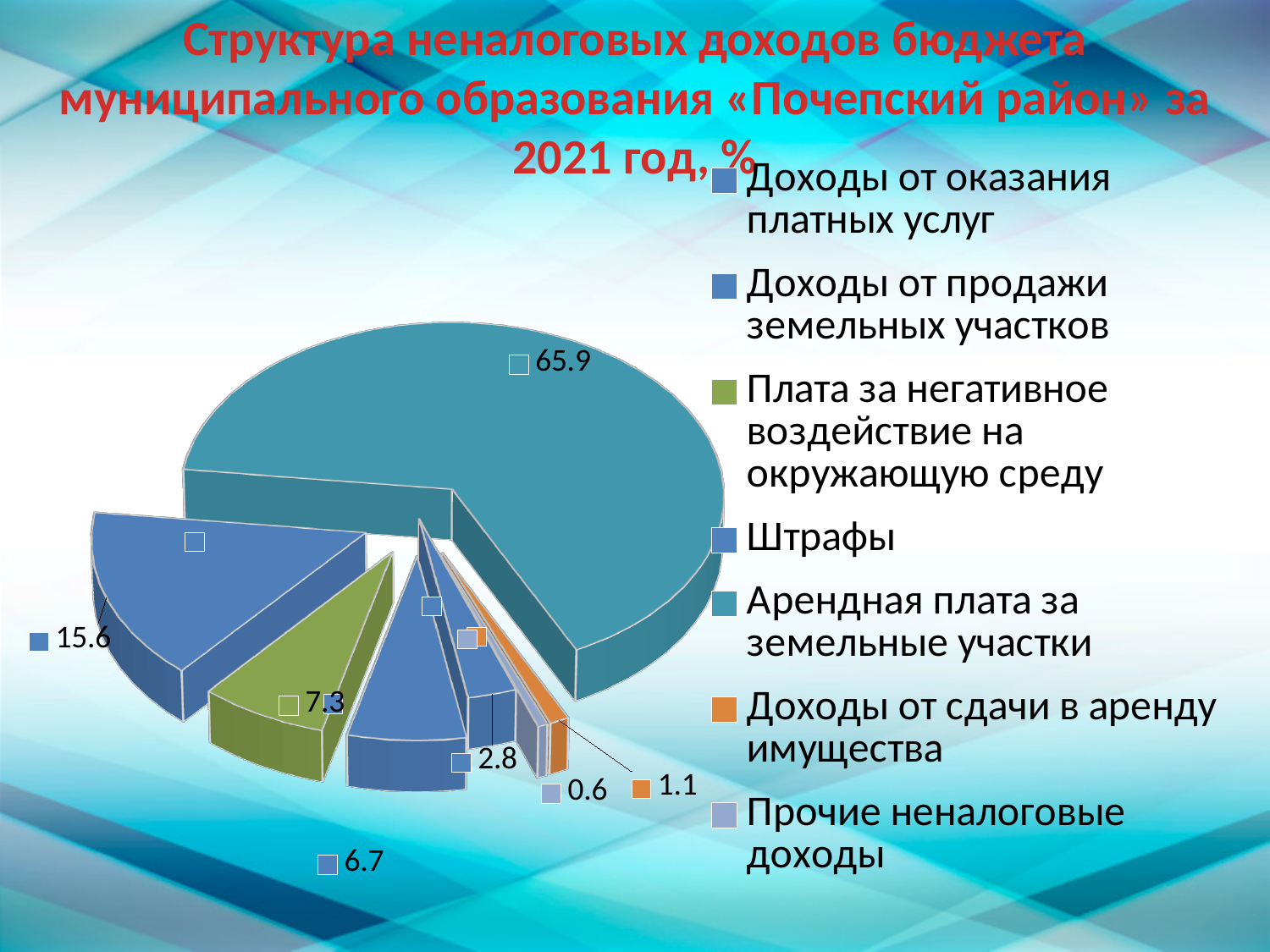
What is the value for Плата за негативное воздействие на окружающую среду? 7.3 What is the value for Доходы от сдачи в аренду имущества? 1.1 Which category has the smallest share of the pie? Прочие неналоговые доходы Which is larger: Доходы от сдачи в аренду имущества or Прочие неналоговые доходы? Доходы от сдачи в аренду имущества What colour is the slice for Доходы от сдачи в аренду имущества? orange What kind of chart is shown on the slide? pie chart How many entries does the legend list? 7 What is the value for Арендная плата за земельные участки? 65.9 What is the difference between the values for Арендная плата за земельные участки and Плата за негативное воздействие на окружающую среду? 58.6 How many slices does the pie chart have? 7 What is the value for Прочие неналоговые доходы? 0.6 Which category has the largest share of the pie? Арендная плата за земельные участки